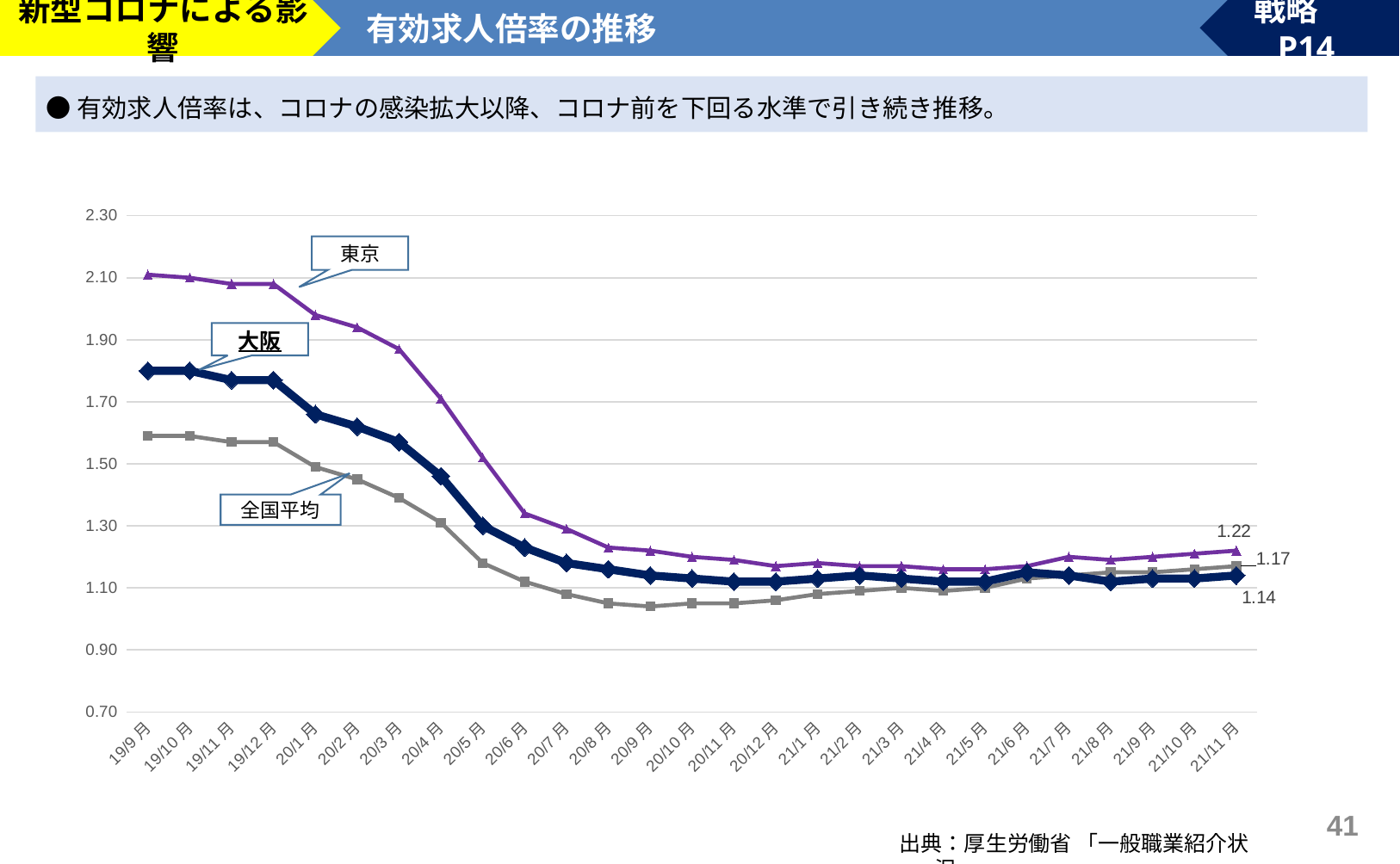
Which series has the highest value at 19/9月? 東京 What is the value for 大阪 at 21/11月? 1.14 Does the 大阪 line rise or fall from 19/9月 to 20/9月? fall Which is larger at 21/11月, the value for 東京 or the value for 大阪? 東京 What is the difference between the 東京 and 大阪 values at 21/11月? 0.08 Is the value for 大阪 at 19/9月 greater or less than 1.70? greater What is the value for 東京 at 21/11月? 1.22 What kind of chart is shown on the slide? line chart What is the title of the chart? 有効求人倍率の推移 Which series has the lowest value at 19/9月? 全国平均 What is the value for 全国平均 at 21/11月? 1.17 How many series are plotted in the chart? 3